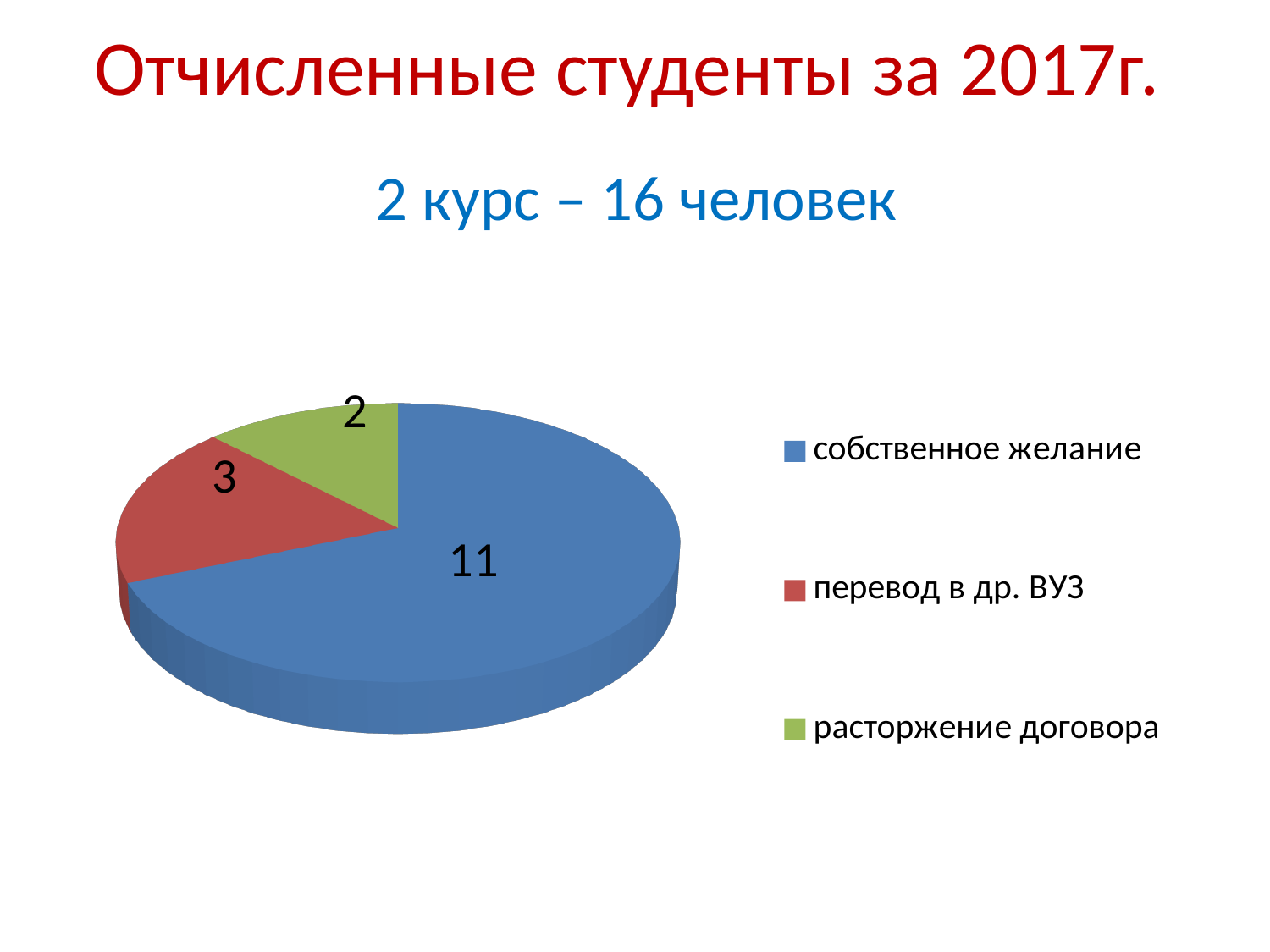
Which is larger, the value for "перевод в др. ВУЗ" or the value for "расторжение договора"? перевод в др. ВУЗ What kind of chart is shown on the slide? pie chart What is the value for "собственное желание"? 11 What is the value for "расторжение договора"? 2 Which category has the smallest slice? расторжение договора What is the total of all slices in the pie chart? 16 How many entries does the legend list? 3 Which category has the largest slice? собственное желание What is the difference between the values for "собственное желание" and "перевод в др. ВУЗ"? 8 What is the value for "перевод в др. ВУЗ"? 3 What colour is the slice for "расторжение договора"? green How many slices does the pie chart have? 3